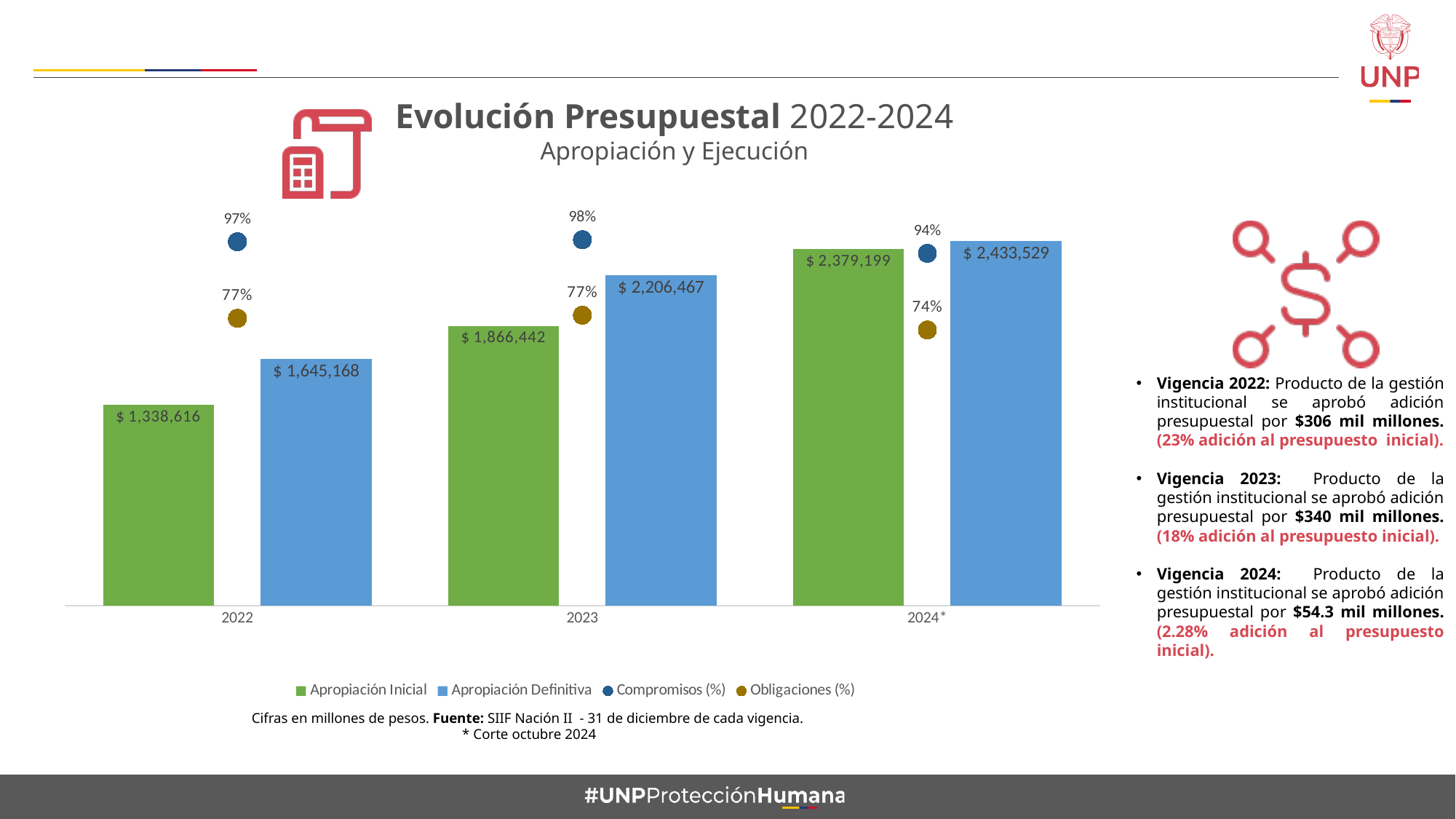
What is the Apropiación Definitiva value for 2023? $ 2,206,467 What is the Compromisos (%) value for 2024*? 94% Which year has the lowest Obligaciones (%)? 2024* Does Apropiación Inicial rise or fall from 2022 to 2024*? Rise What is the Apropiación Inicial value for 2022? $ 1,338,616 What kind of chart is used to show Apropiación Inicial and Apropiación Definitiva? Bar chart What is the Obligaciones (%) value for 2023? 77% Which year has the highest Apropiación Definitiva? 2024* Which is larger in 2022, Apropiación Inicial or Apropiación Definitiva? Apropiación Definitiva How many years are shown on the x axis of the chart? 3 What is the difference between Apropiación Definitiva and Apropiación Inicial in 2023? $ 340,025 How many series does the chart legend list? 4